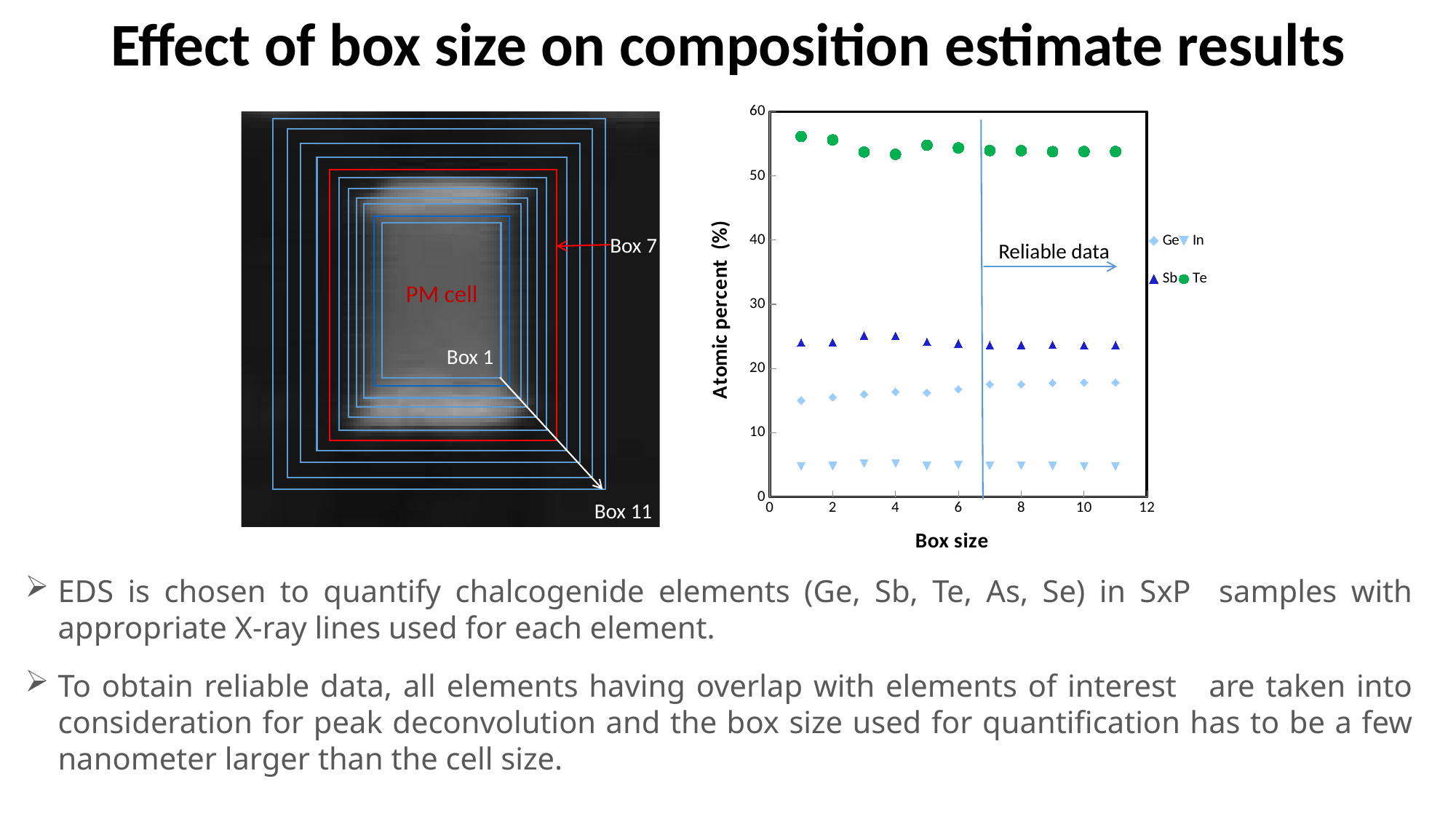
Is the In value at box size 4 greater or less than 10? less Is the Sb value at box size 3 greater or less than 20? greater How many box sizes (data points per series) are plotted on the chart? 11 How many series does the chart's legend list? 4 At box size 5, which is larger, the Sb value or the Ge value? Sb Which series has the highest atomic percent values across all box sizes? Te What kind of chart is shown on the slide? scatter chart Which series has the lowest atomic percent values across all box sizes? In What is the title of the chart's x axis? Box size Which series are listed in the chart's legend? Ge, In, Sb, Te Is the Ge value at box size 1 greater or less than 20? less